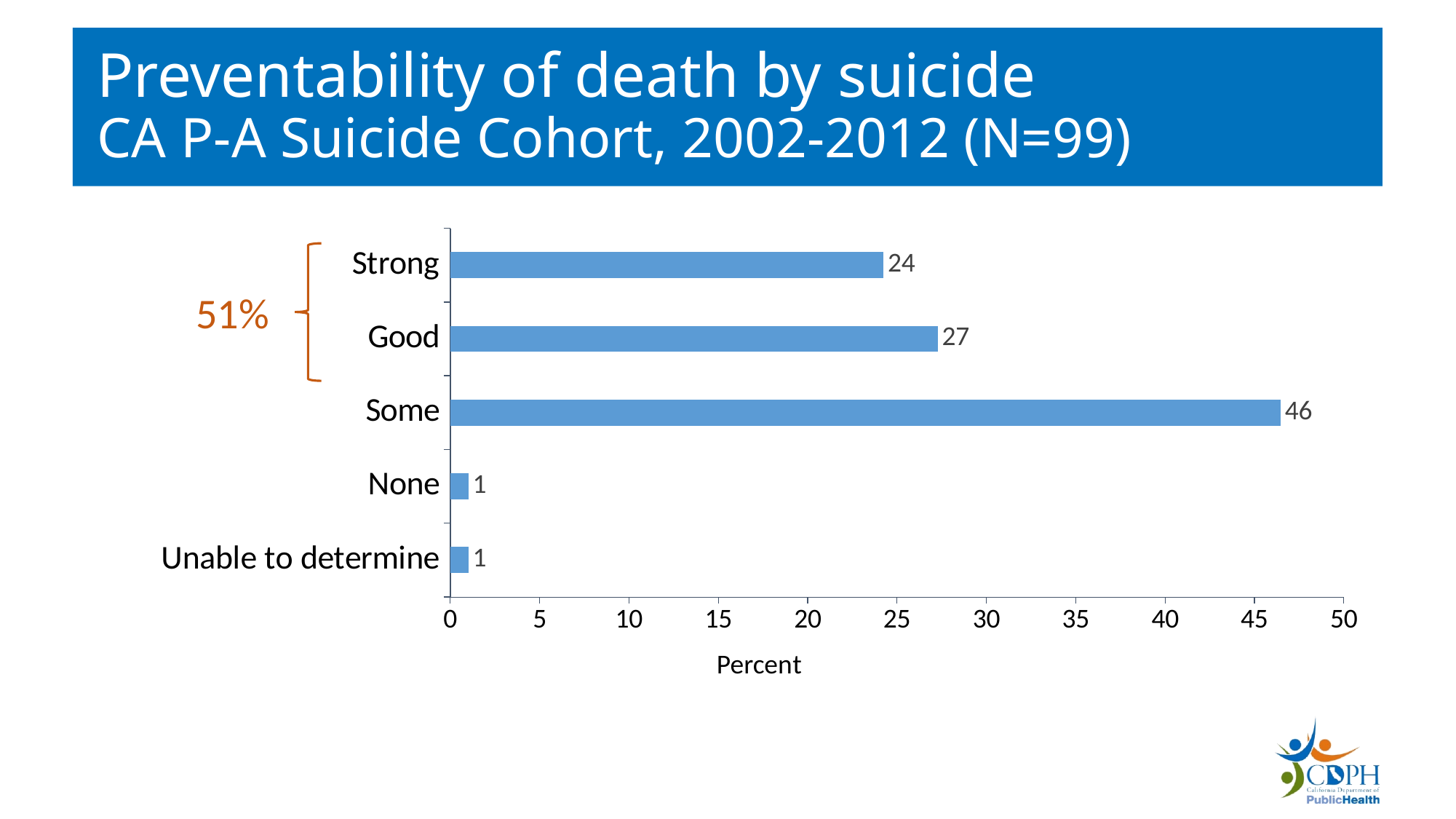
What is the label on the horizontal axis? Percent What is the value for Some? 46 What is the difference between the values for Good and Strong? 3 What is the value for Unable to determine? 1 What is the value for Good? 27 Which category has the highest value? Some What kind of chart is shown on the slide? bar chart Which is larger, the value for Strong or the value for Good? Good How many categories are shown on the chart? 5 What is the difference between the values for Some and Good? 19 Is the value for Some greater or less than 40? greater What is the value for Strong? 24